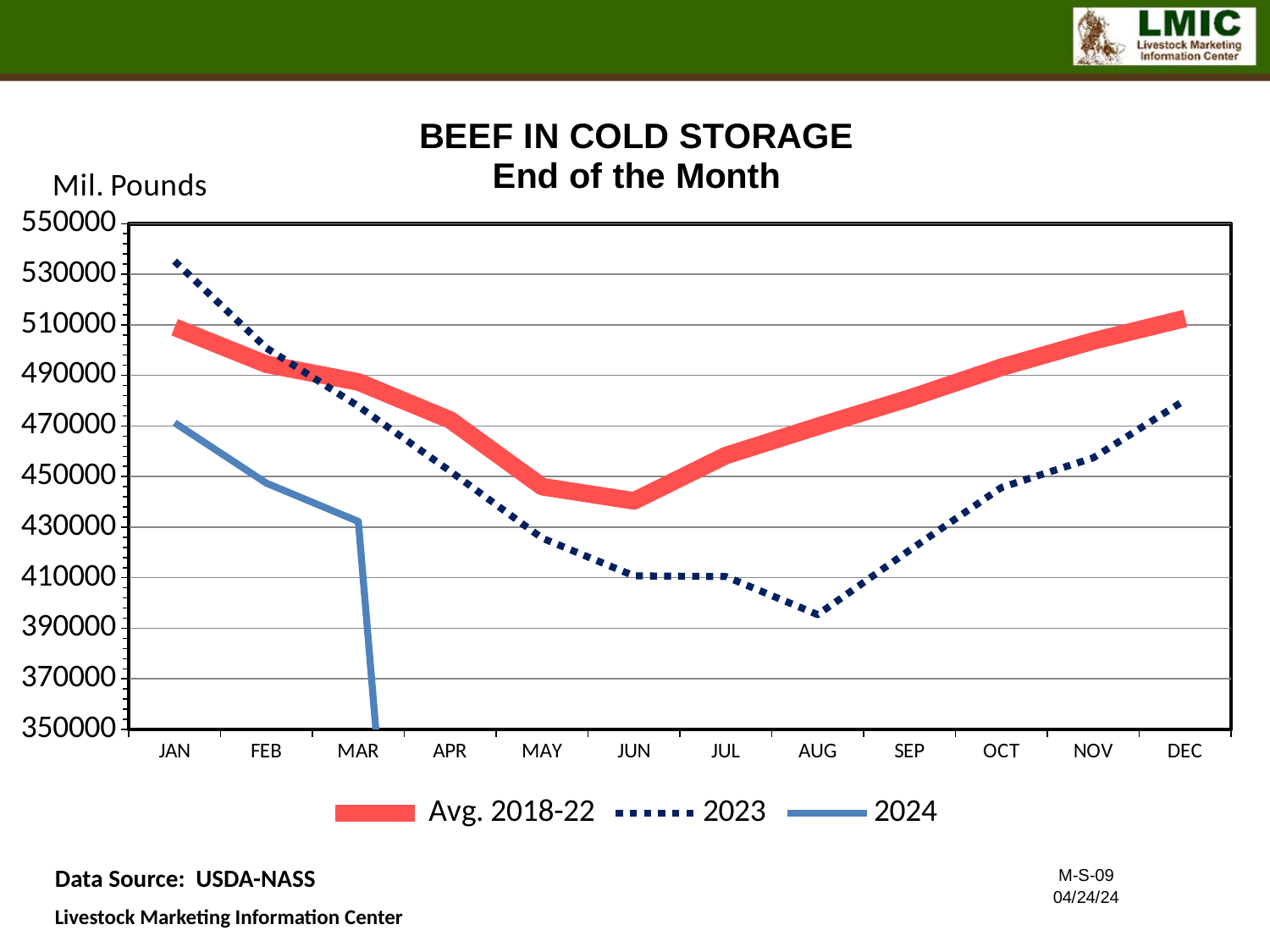
Is the Avg. 2018-22 value for JUN greater or less than 450000? less In which month is the 2023 series at its lowest? AUG Does the 2023 series rise or fall from JAN to AUG? fall In MAR, which is larger: the 2024 value or the Avg. 2018-22 value? Avg. 2018-22 Is the 2024 value for JAN greater or less than 450000? greater In JAN, which is larger: the 2023 value or the Avg. 2018-22 value? 2023 In which month is the 2023 series at its highest? JAN How many months are shown along the x axis? 12 What kind of chart is shown on the slide? line chart How many series does the legend list? 3 Is the 2023 value for JAN greater or less than 510000? greater